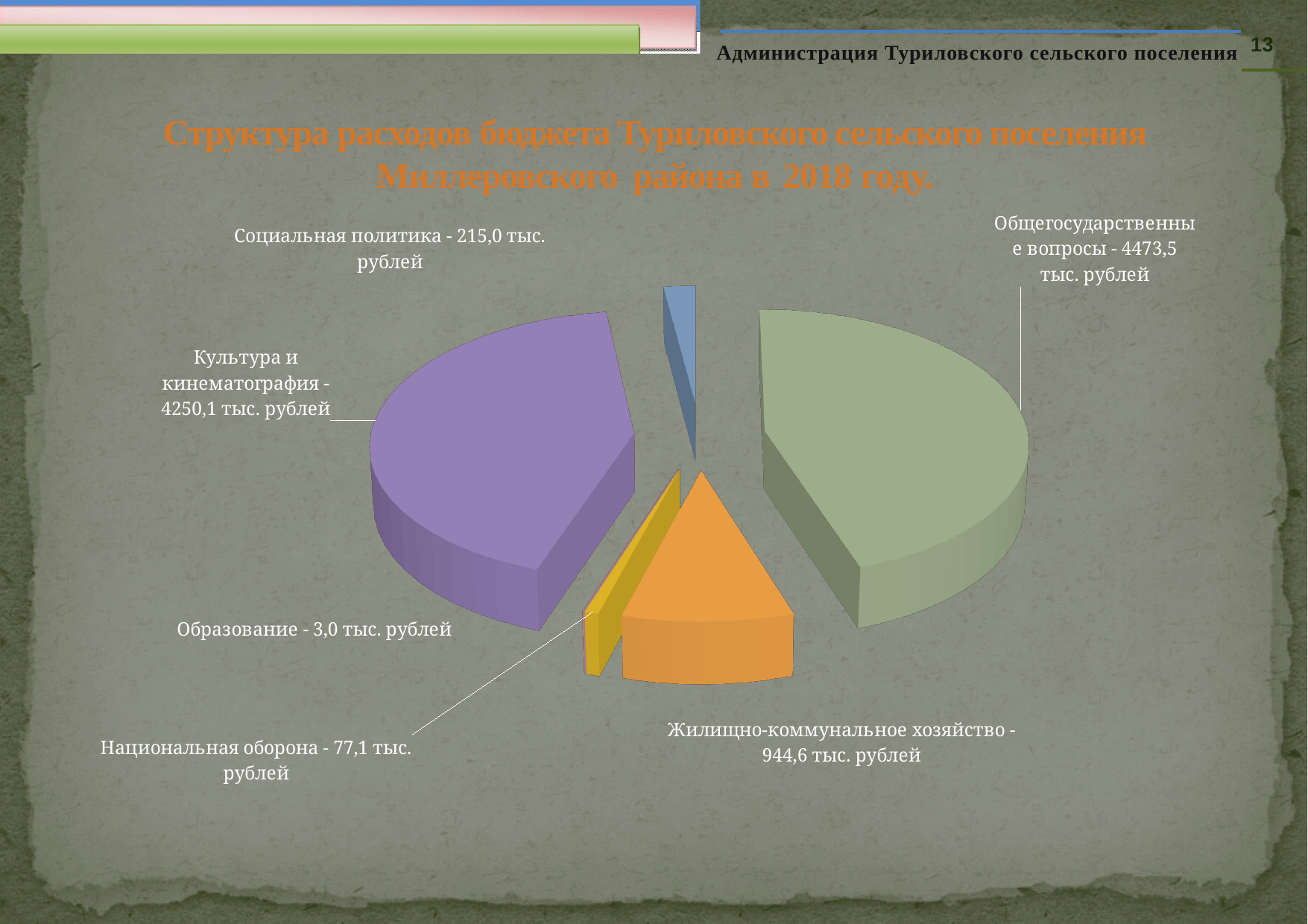
What is the value for Культура и кинематография? 4250,1 тыс. рублей What year does the chart title say the budget expenditure structure refers to? 2018 What is the difference between Общегосударственные вопросы and Культура и кинематография? 223,4 тыс. рублей What is the value for Национальная оборона? 77,1 тыс. рублей Which category has the smallest expenditure? Образование Which is larger: Социальная политика or Жилищно-коммунальное хозяйство? Жилищно-коммунальное хозяйство What is the value for Жилищно-коммунальное хозяйство? 944,6 тыс. рублей What is the value for Общегосударственные вопросы? 4473,5 тыс. рублей Which category has the largest expenditure? Общегосударственные вопросы How many slices does the pie chart have? 6 What kind of chart is shown on the slide? Pie chart What is the total of all expenditure categories shown in the pie chart? 9963,3 тыс. рублей